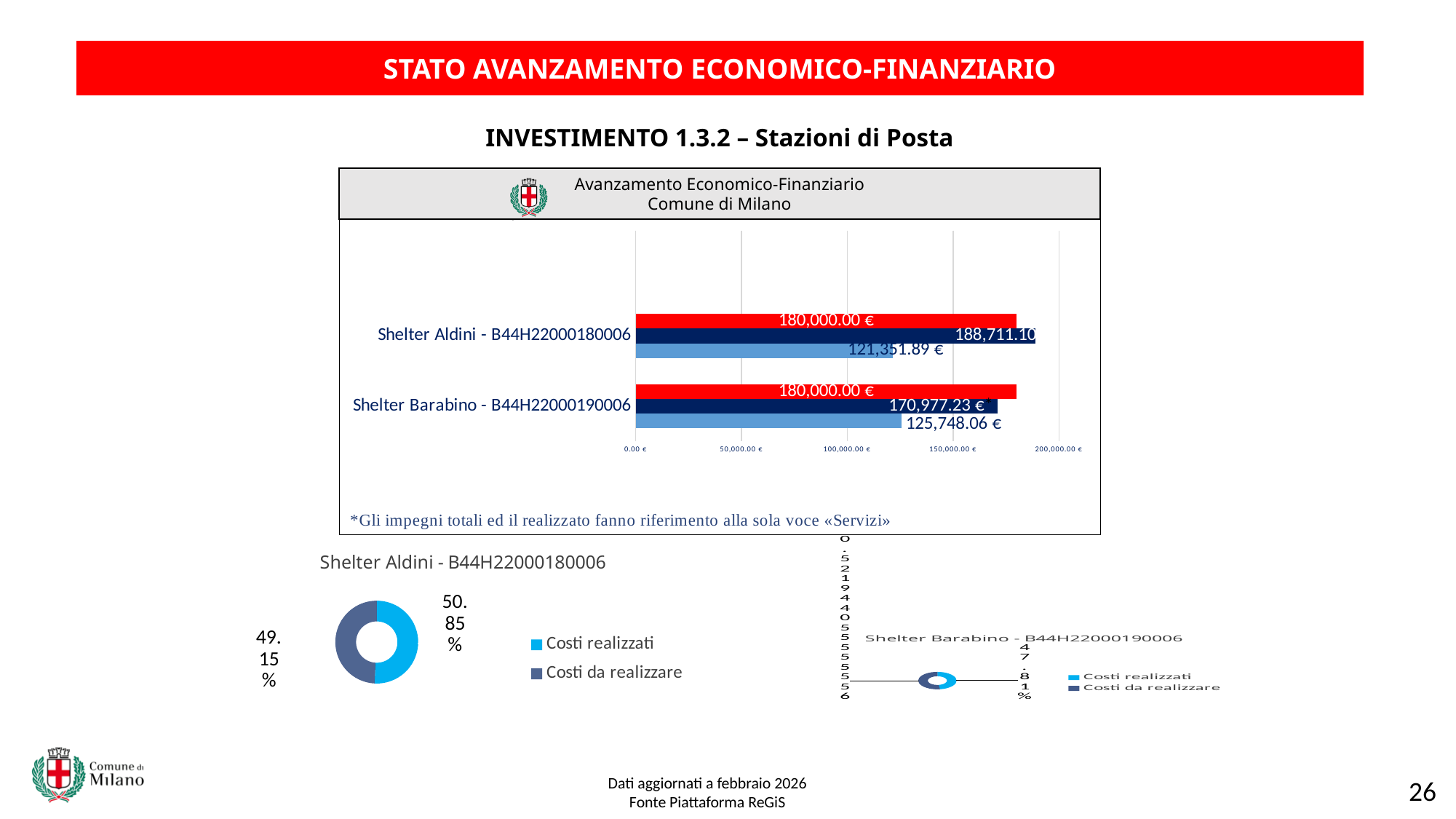
In the bar chart titled 'Avanzamento Economico-Finanziario Comune di Milano', is the light blue bar for Shelter Aldini - B44H22000180006 greater or less than 150,000.00 €? less What kind of chart is the 'Avanzamento Economico-Finanziario Comune di Milano' chart? bar chart In the bar chart titled 'Avanzamento Economico-Finanziario Comune di Milano', what is the value of the dark blue bar for Shelter Barabino - B44H22000190006? 170,977.23 € In the donut chart titled 'Shelter Aldini - B44H22000180006', what share is shown for Costi da realizzare? 49.15% In the bar chart titled 'Avanzamento Economico-Finanziario Comune di Milano', what is the difference between the light blue bars of Shelter Barabino and Shelter Aldini? 4,396.17 € In the donut chart titled 'Shelter Aldini - B44H22000180006', what share is shown for Costi realizzati? 50.85% In the bar chart titled 'Avanzamento Economico-Finanziario Comune di Milano', what is the value of the light blue bar for Shelter Barabino - B44H22000190006? 125,748.06 € In the bar chart titled 'Avanzamento Economico-Finanziario Comune di Milano', how many categories are shown on the vertical axis? 2 In the bar chart titled 'Avanzamento Economico-Finanziario Comune di Milano', what is the value of the light blue bar for Shelter Aldini - B44H22000180006? 121,351.89 € How many entries does the legend of the donut chart titled 'Shelter Aldini - B44H22000180006' list? 2 In the bar chart titled 'Avanzamento Economico-Finanziario Comune di Milano', what is the value of the red bar for Shelter Aldini - B44H22000180006? 180,000.00 € In the bar chart titled 'Avanzamento Economico-Finanziario Comune di Milano', which category has the larger light blue bar, Shelter Aldini or Shelter Barabino? Shelter Barabino - B44H22000190006